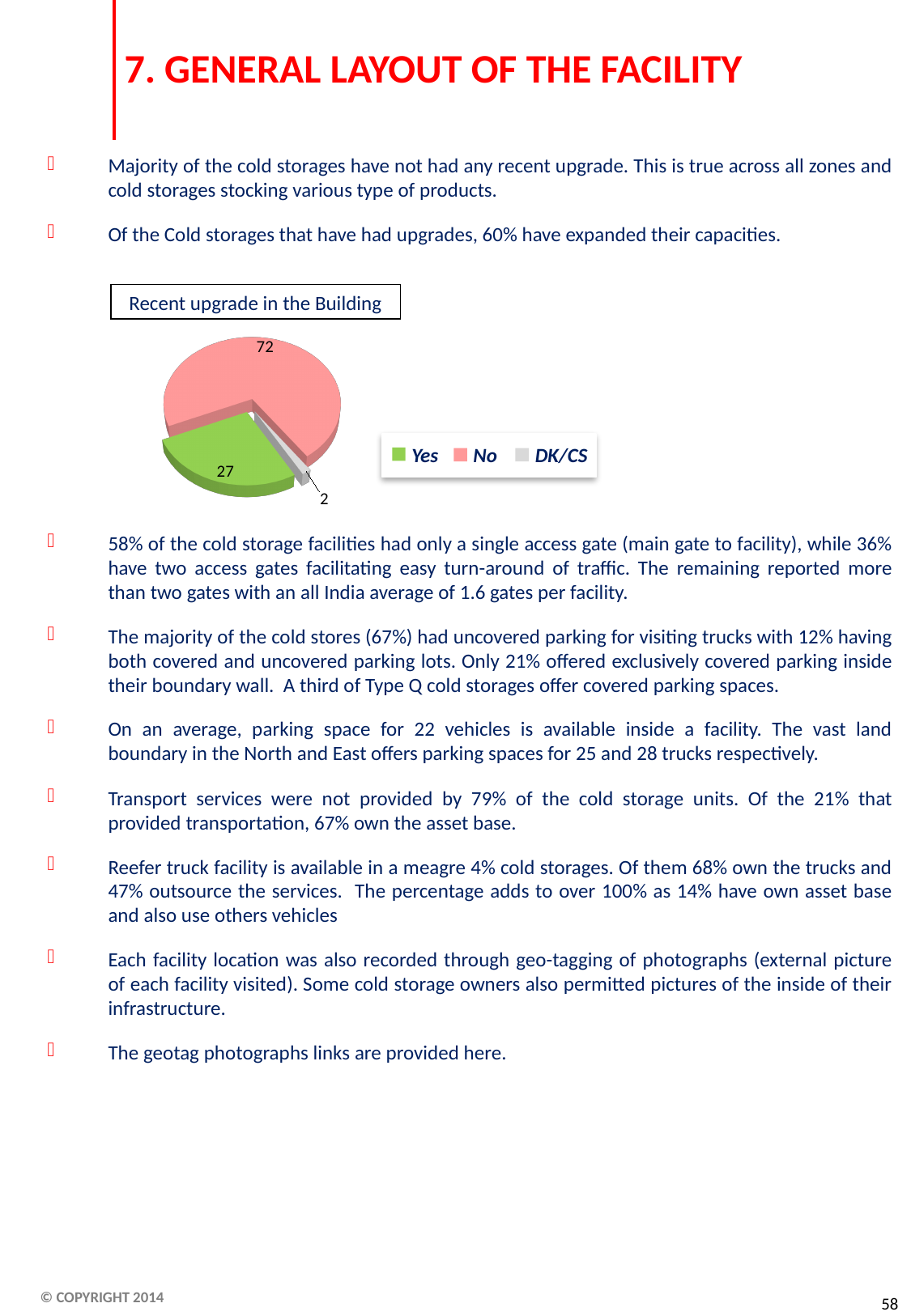
Which category has the largest slice in the "Recent upgrade in the Building" pie chart? No What is the value for "Yes" in the "Recent upgrade in the Building" pie chart? 27 In the "Recent upgrade in the Building" pie chart, what is the difference between the values for "Yes" and "DK/CS"? 25 In the "Recent upgrade in the Building" pie chart, what is the difference between the values for "No" and "Yes"? 45 What type of chart is shown under the title "Recent upgrade in the Building"? Pie chart How many entries does the legend of the "Recent upgrade in the Building" pie chart list? 3 How many categories does the "Recent upgrade in the Building" pie chart show? 3 What colour is the "Yes" slice in the "Recent upgrade in the Building" pie chart? Green In the "Recent upgrade in the Building" pie chart, which is larger: the value for "Yes" or the value for "No"? No What is the value for "DK/CS" in the "Recent upgrade in the Building" pie chart? 2 What is the value for "No" in the "Recent upgrade in the Building" pie chart? 72 Which category has the smallest slice in the "Recent upgrade in the Building" pie chart? DK/CS